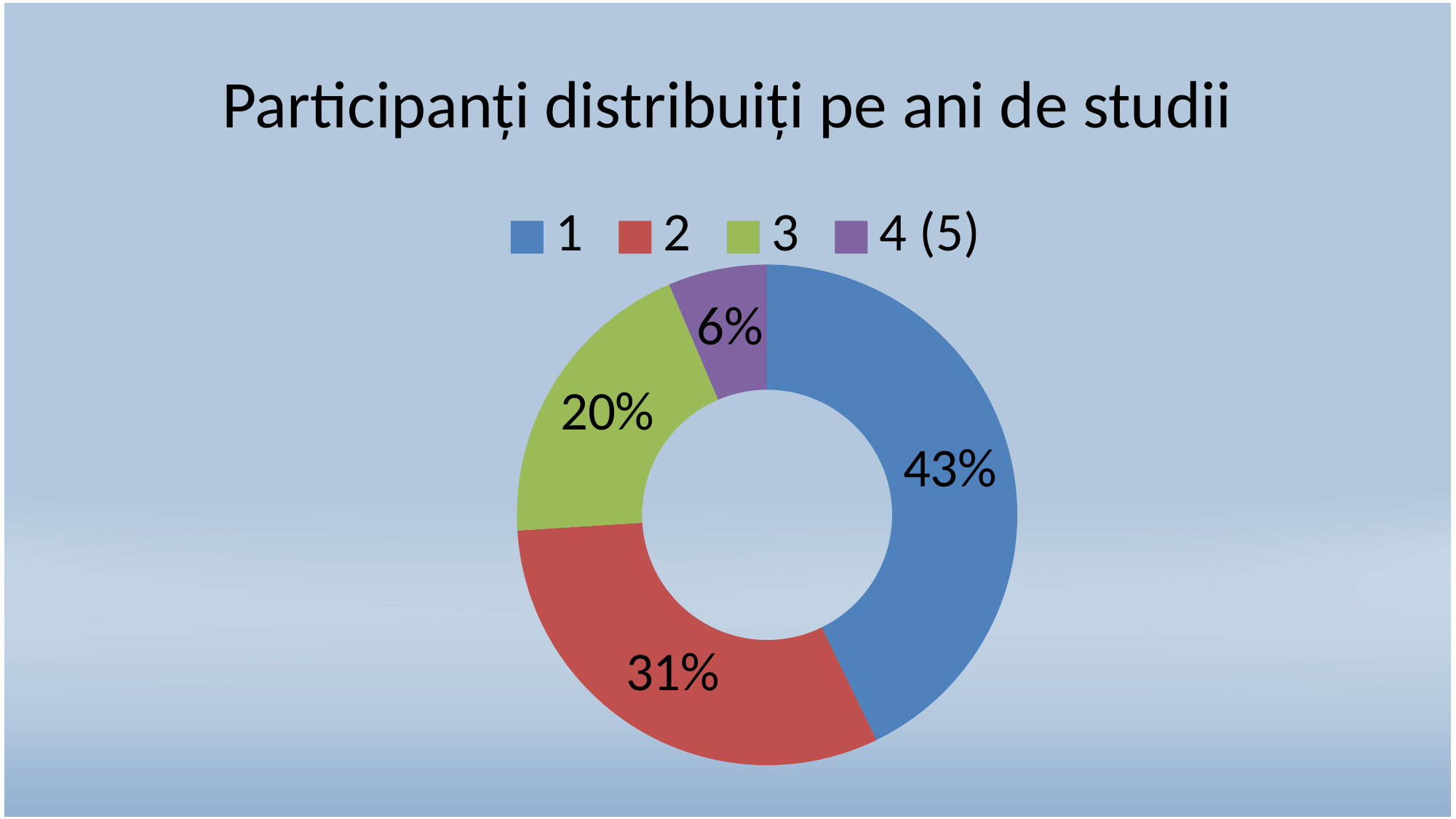
What share of participants are in year 4 (5)? 6% What share of participants are in year 2? 31% What is the difference in percentage points between the shares for year 1 and year 2? 12 Which year of study has the smallest share of participants? 4 (5) What kind of chart is shown on the slide? Doughnut chart What colour is the slice for year 3? Green What share of participants are in year 1? 43% What is the title of the chart? Participanți distribuiți pe ani de studii Which year of study has the largest share of participants? 1 Which has a larger share of participants, year 2 or year 3? 2 How many categories does the chart show? 4 What share of participants are in year 3? 20%